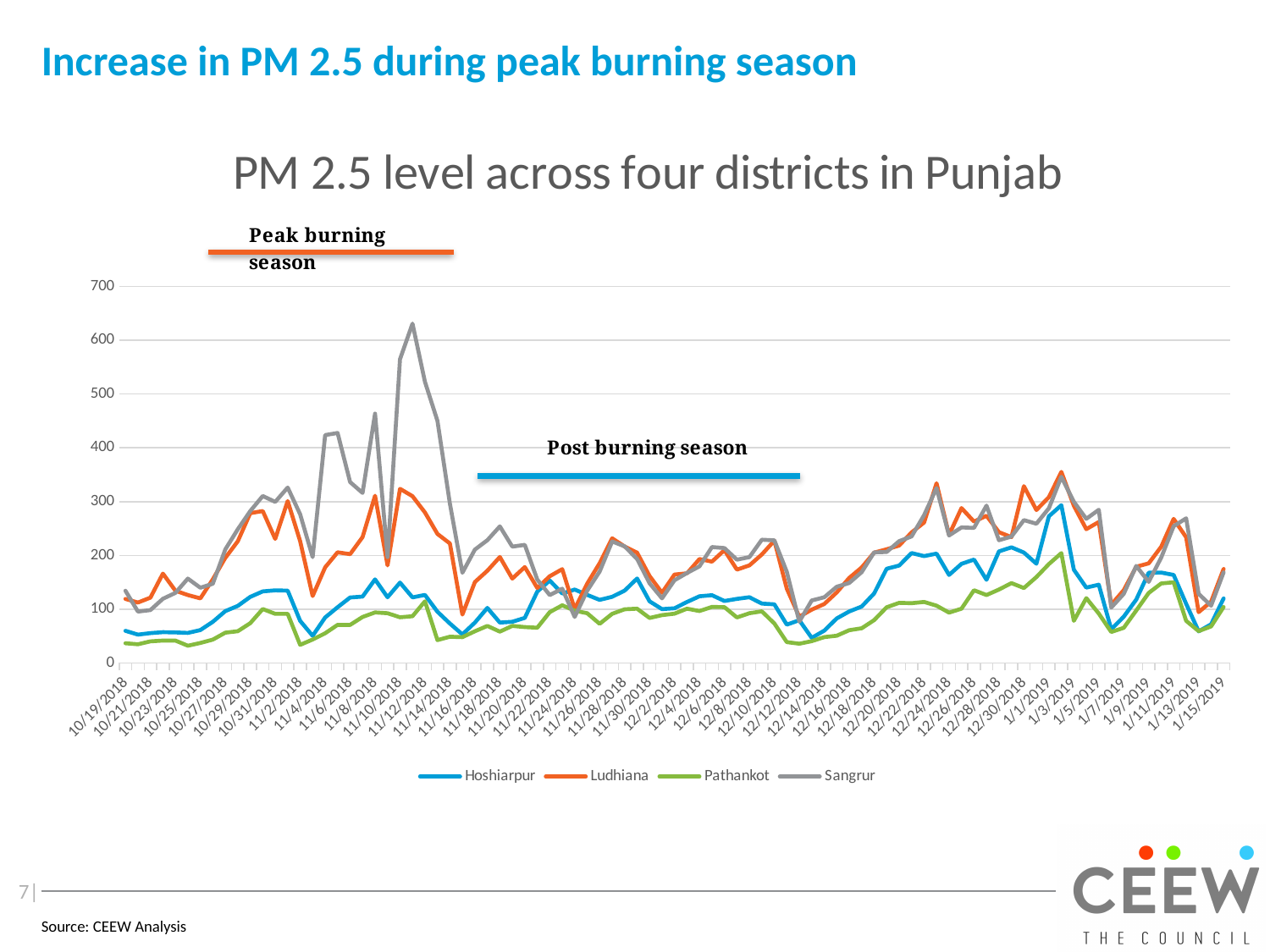
What kind of chart is shown on the slide? line chart Is the peak value for Sangrur greater or less than 600? greater Around 11/10/2018, which is larger, the value for Sangrur or the value for Pathankot? Sangrur How many series does the legend list? 4 Which district's line reaches the highest PM 2.5 value on the chart? Sangrur Which series is drawn in orange? Ludhiana What is the highest value shown on the vertical axis? 700 Is the highest value for Pathankot greater or less than 300? less Which district's line stays lowest across most of the period? Pathankot What is the title of the chart? PM 2.5 level across four districts in Punjab Is the value for Pathankot on 11/2/2018 greater or less than 100? less